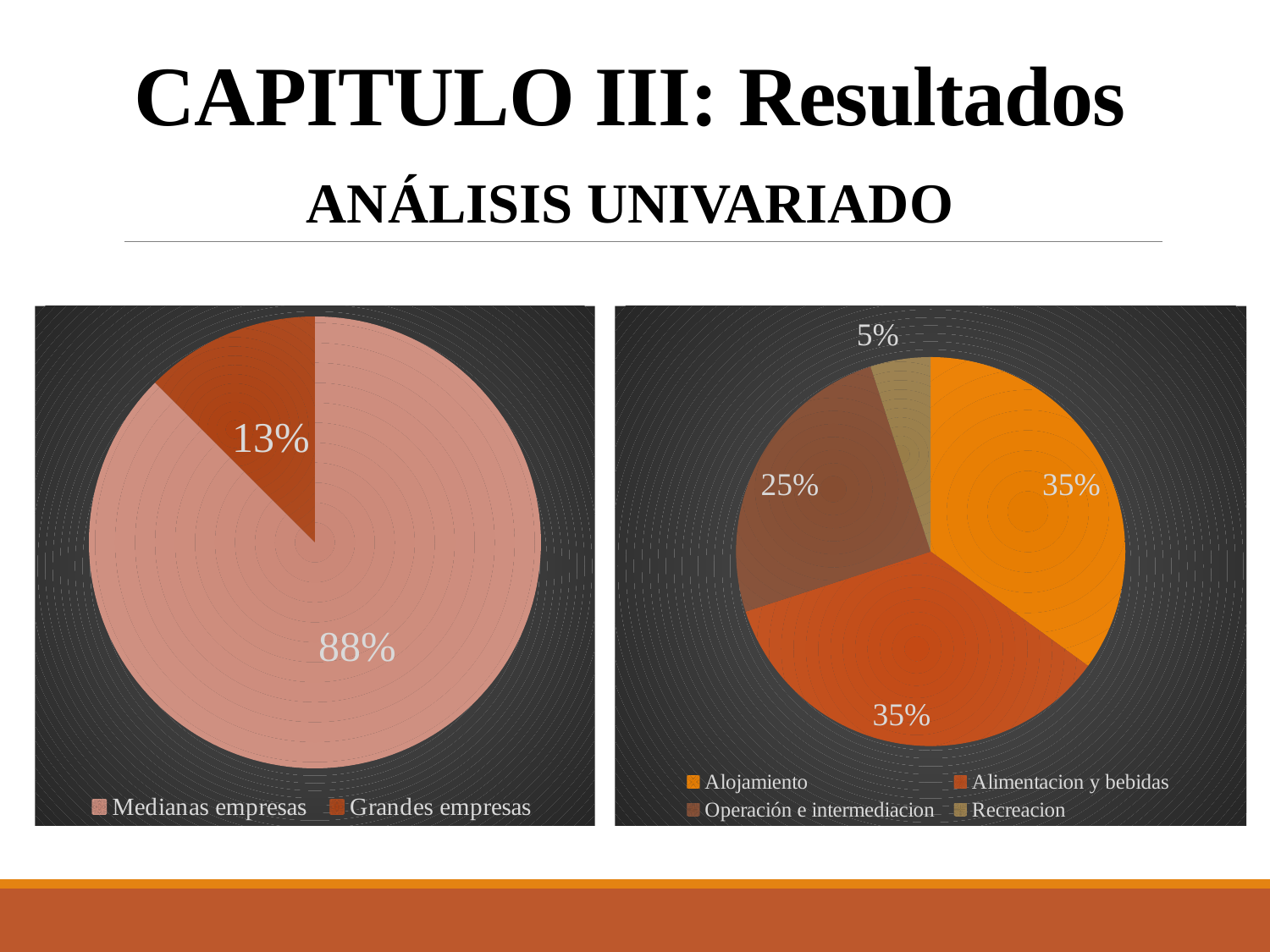
How many categories does the legend of the right pie chart list? 4 What kind of chart is the left chart on the slide? Pie chart In the left pie chart, which category has the largest slice? Medianas empresas In the right pie chart, what share is shown for Recreacion? 5% In the left pie chart, what share is shown for Medianas empresas? 88% How many categories does the legend of the left pie chart list? 2 In the right pie chart, what share is shown for Operación e intermediacion? 25% In the right pie chart, which is larger: the share for Operación e intermediacion or the share for Recreacion? Operación e intermediacion In the right pie chart, what share is shown for Alojamiento? 35% In the right pie chart, which category has the smallest slice? Recreacion In the left pie chart, what share is shown for Grandes empresas? 13% In the left pie chart, what is the difference between the shares of Medianas empresas and Grandes empresas? 75%